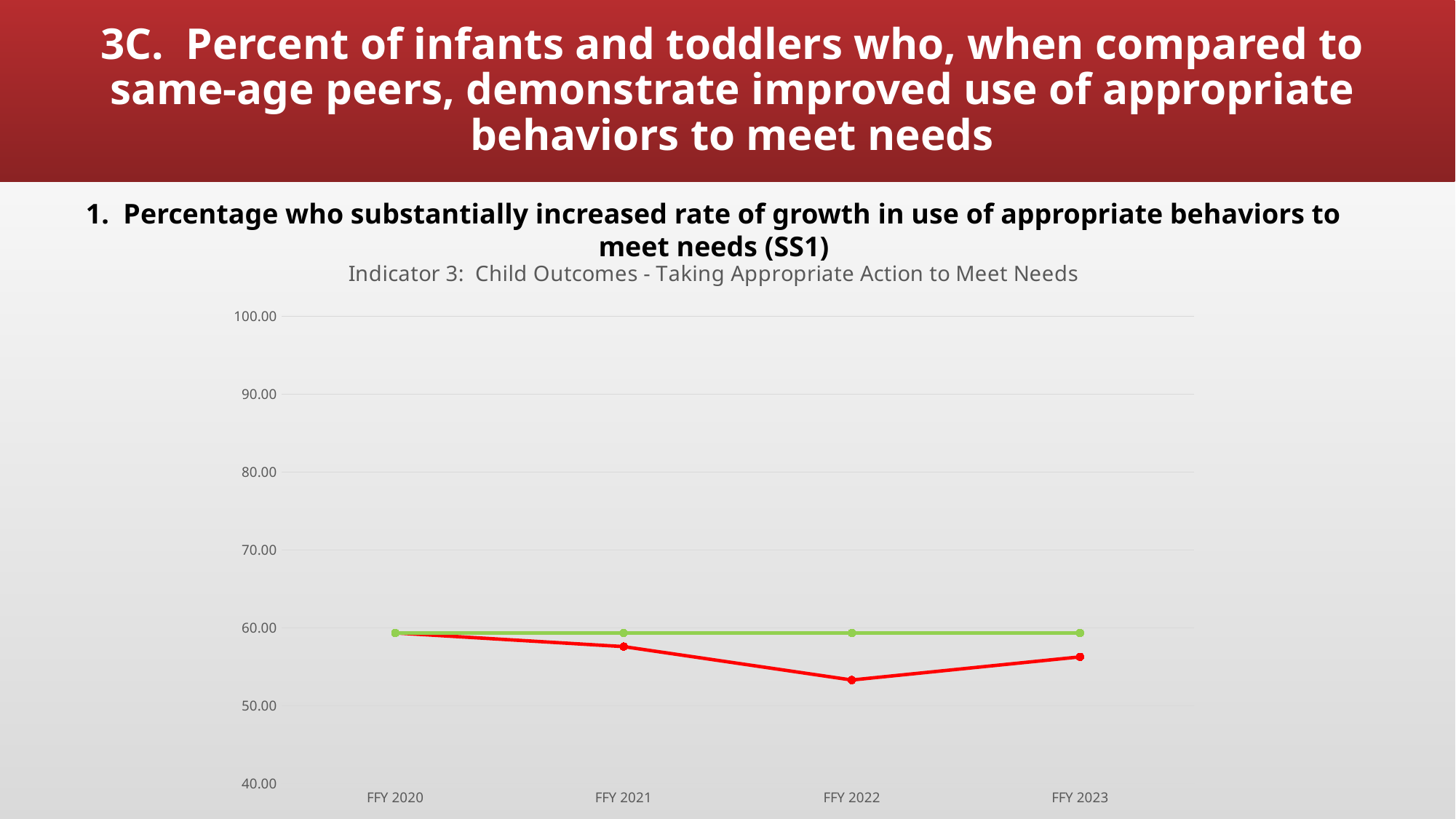
Does the red line rise or fall from FFY 2020 to FFY 2022? fall What kind of chart is shown on the slide? line chart Is the value of the red line for FFY 2022 greater or less than 50? greater What is the title of the chart? Indicator 3: Child Outcomes - Taking Appropriate Action to Meet Needs Is the value of the red line for FFY 2023 greater or less than 60? less Is the value of the red line for FFY 2022 greater or less than 60? less Which is larger for the red line, the value for FFY 2021 or the value for FFY 2022? FFY 2021 How many lines are plotted on the chart? 2 How many fiscal years are plotted along the x axis? 4 At FFY 2022, which line has the higher value, the green line or the red line? green line In which fiscal year does the red line reach its lowest point? FFY 2022